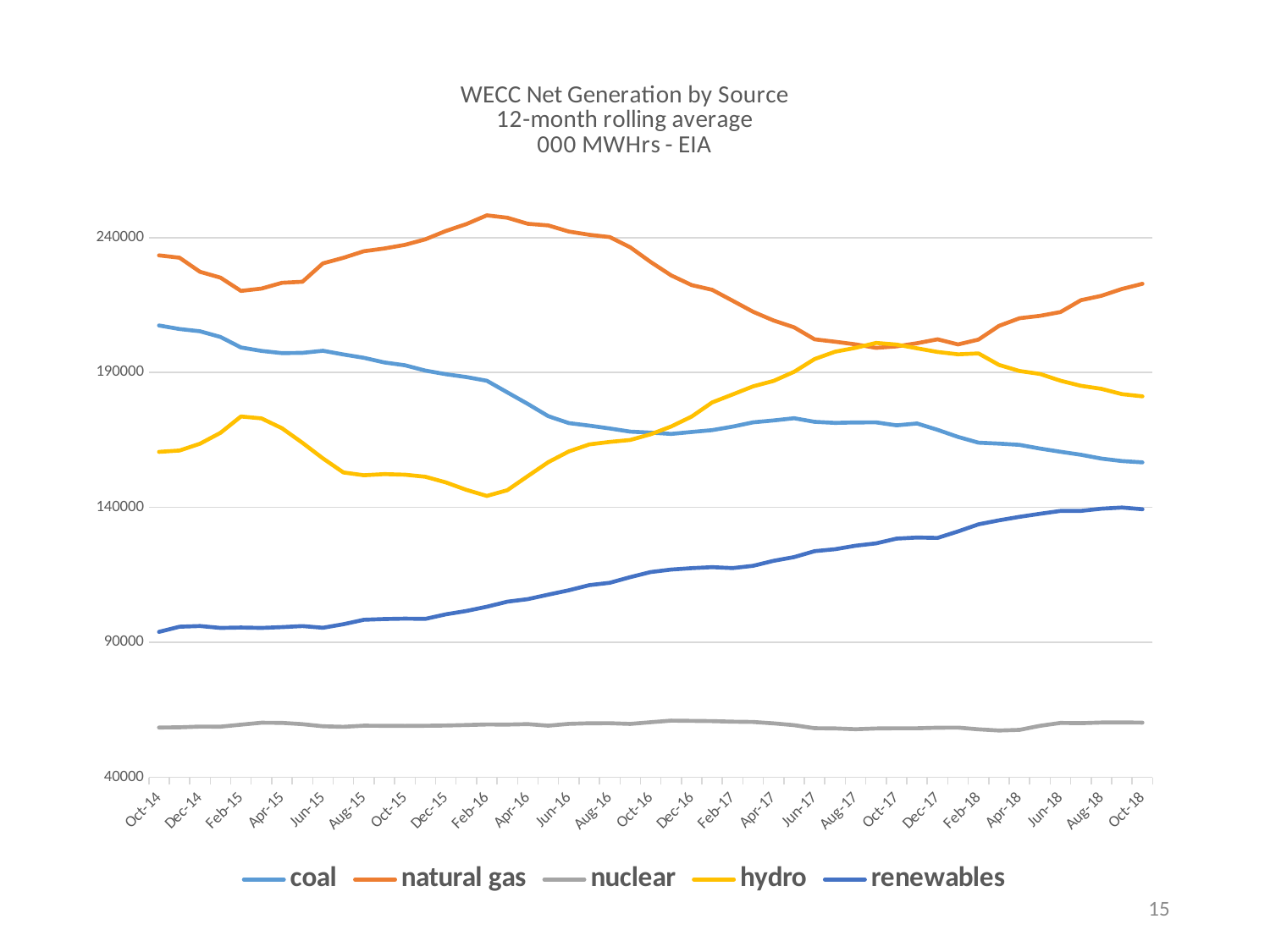
What kind of chart is shown on the slide? line chart Is the value for natural gas at Feb-16 greater or less than 240000? greater Do the values for renewables rise or fall from Oct-14 to Oct-18? rise What is the first line of the chart title? WECC Net Generation by Source Is the value for nuclear at Oct-17 greater or less than 90000? less Is the value for coal at Oct-14 greater or less than 190000? greater How many series does the legend list? 5 At Oct-18, which is larger, the value for hydro or the value for coal? hydro Do the values for coal rise or fall from Oct-14 to Oct-18? fall Which series has the highest values across the whole period? natural gas Which series has the lowest values across the whole period? nuclear